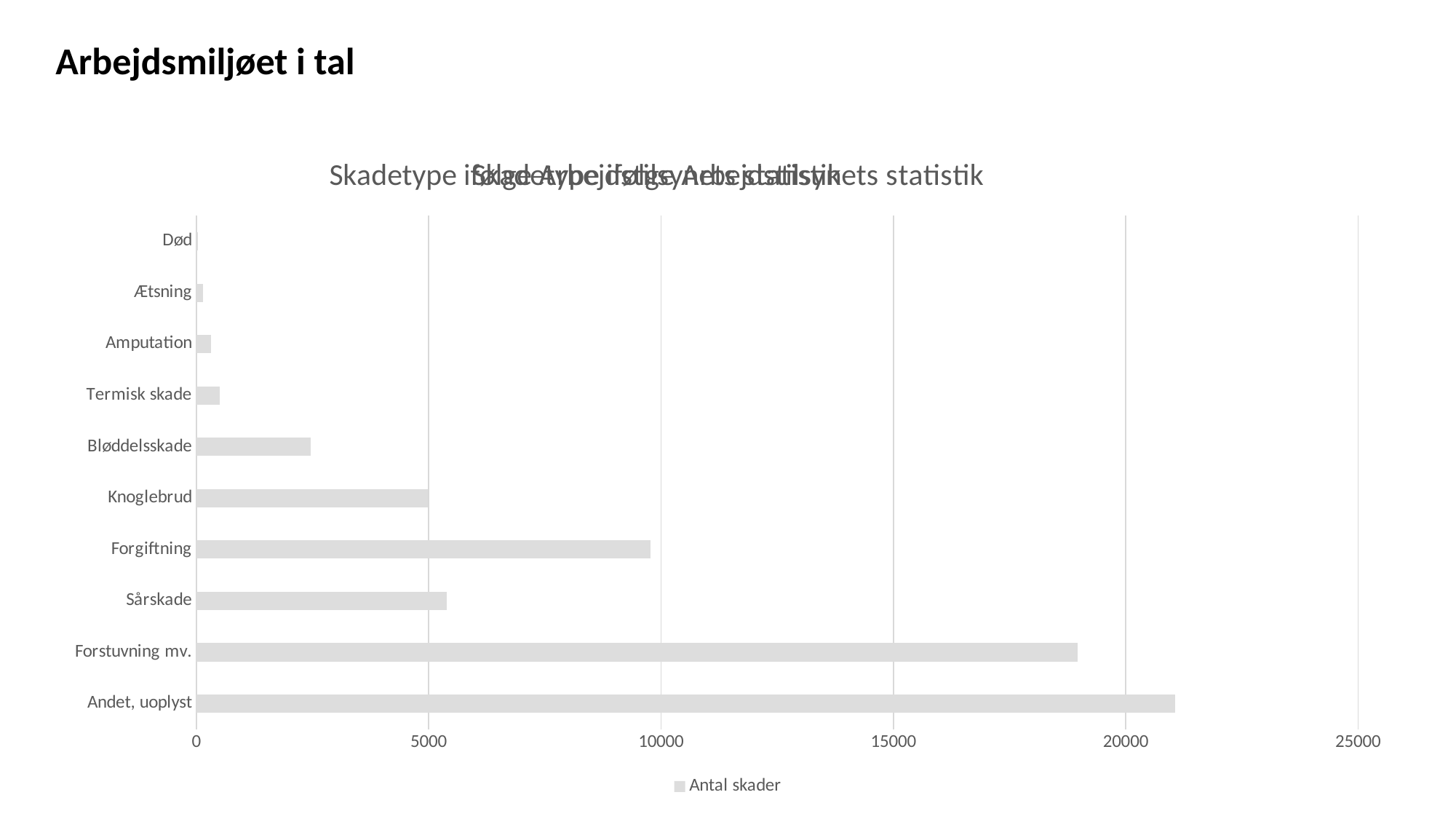
Is the value for Forstuvning mv. greater or less than 15000? greater How many injury-type categories are plotted on the chart? 10 Which is larger, the value for Forgiftning or the value for Knoglebrud? Forgiftning Is the value for Bløddelsskade greater or less than 5000? less What kind of chart is shown on the slide? bar chart What is the name of the series shown in the chart legend? Antal skader Is the value for Andet, uoplyst greater or less than 20000? greater Which is larger, the value for Forstuvning mv. or the value for Sårskade? Forstuvning mv. Which category has the lowest value on the chart? Død Which category has the highest value on the chart? Andet, uoplyst How many series does the chart legend list? 1